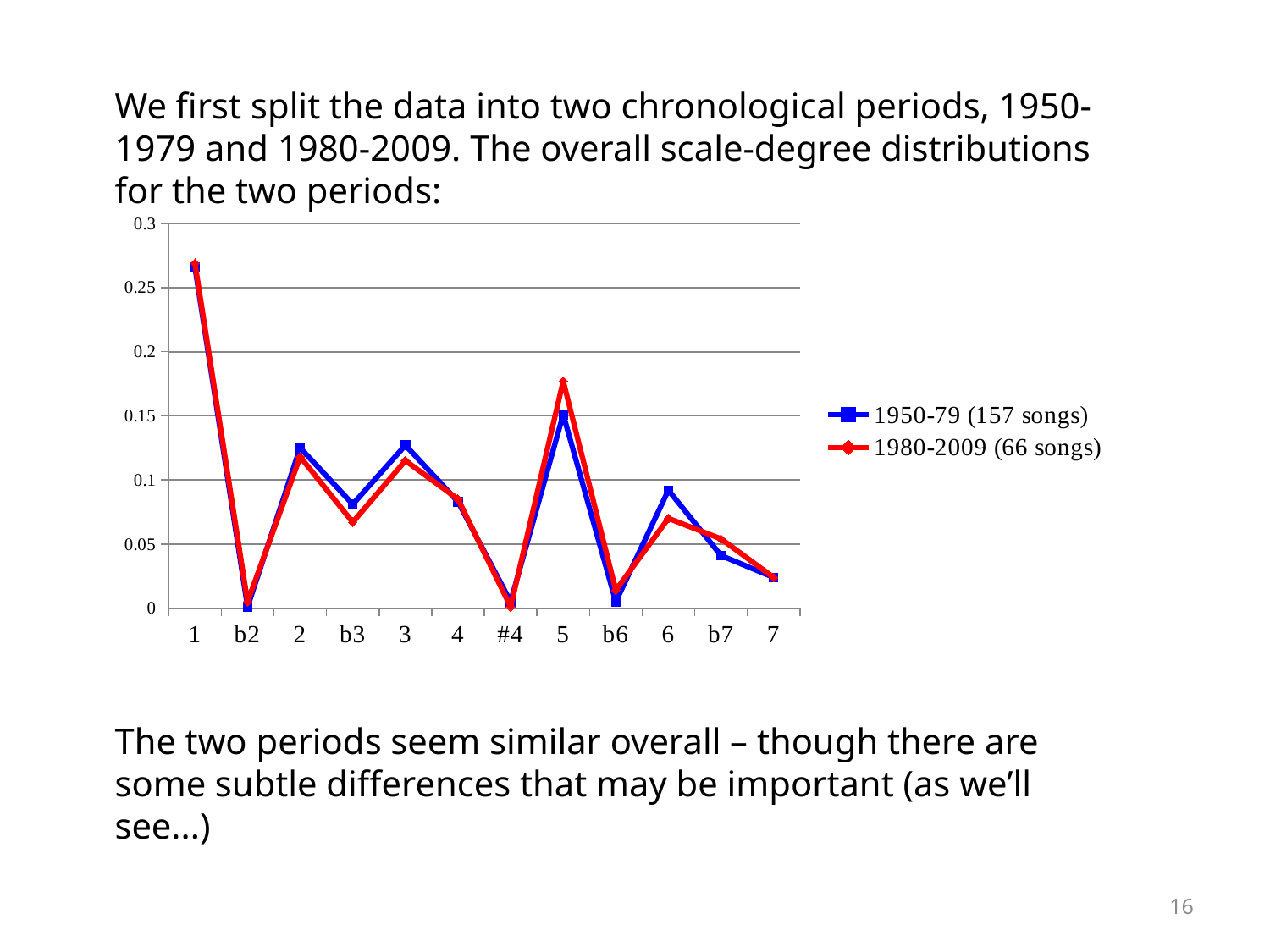
Is the value for scale degree 5 in the 1980-2009 series greater or less than 0.15? greater At scale degree 6, which series has the larger value, 1950-79 or 1980-2009? 1950-79 Which scale degree has the highest value for the 1980-2009 series? 1 Is the value for scale degree b6 in the 1950-79 series greater or less than 0.05? less Which scale degree has the highest value for the 1950-79 series? 1 Is the value for scale degree 2 in the 1950-79 series greater or less than 0.1? greater How many series does the chart's legend list? 2 What kind of chart is shown on the slide? line chart At scale degree 5, which series has the larger value, 1950-79 or 1980-2009? 1980-2009 How many songs does the legend say are in the 1980-2009 series? 66 songs How many scale-degree categories are shown along the x axis of the chart? 12